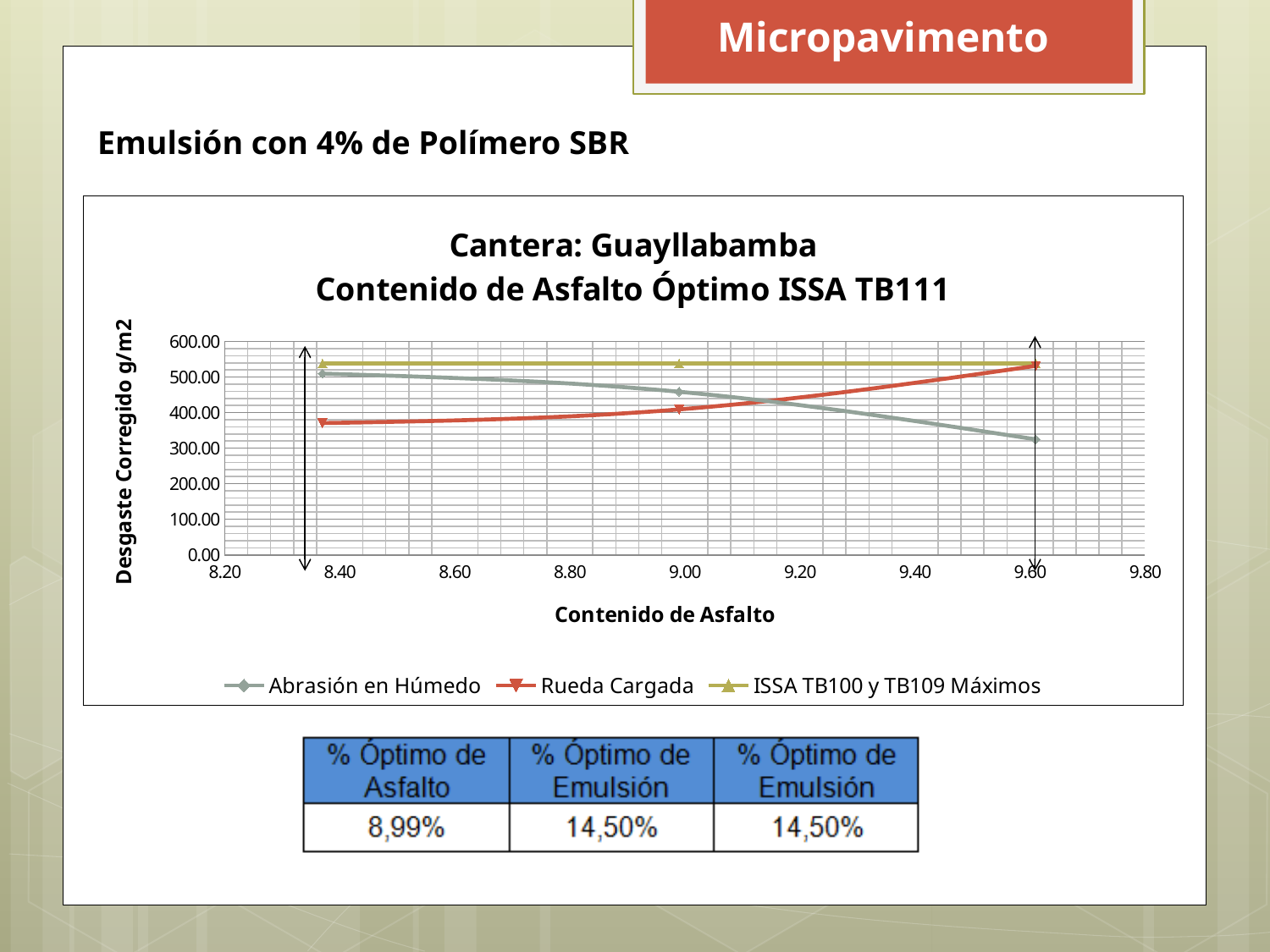
What kind of chart is shown on the slide? line chart Is the Rueda Cargada value at its first point (near 8.40) greater or less than 400.00? less At a Contenido de Asfalto of about 9.60, which series has the higher value, Abrasión en Húmedo or Rueda Cargada? Rueda Cargada How many data points are plotted for the Rueda Cargada series? 3 Does the Rueda Cargada series rise or fall as Contenido de Asfalto increases? rise What is the label of the vertical axis of the chart? Desgaste Corregido g/m2 Is the Abrasión en Húmedo value at its last point (near 9.60) greater or less than 400.00? less What is the title of the chart? Cantera: Guayllabamba Contenido de Asfalto Óptimo ISSA TB111 How many series does the chart legend list? 3 Is the value of the ISSA TB100 y TB109 Máximos line greater or less than 500.00? greater At a Contenido de Asfalto of about 9.00, which series has the higher value, Abrasión en Húmedo or Rueda Cargada? Abrasión en Húmedo Does the Abrasión en Húmedo series rise or fall as Contenido de Asfalto increases? fall